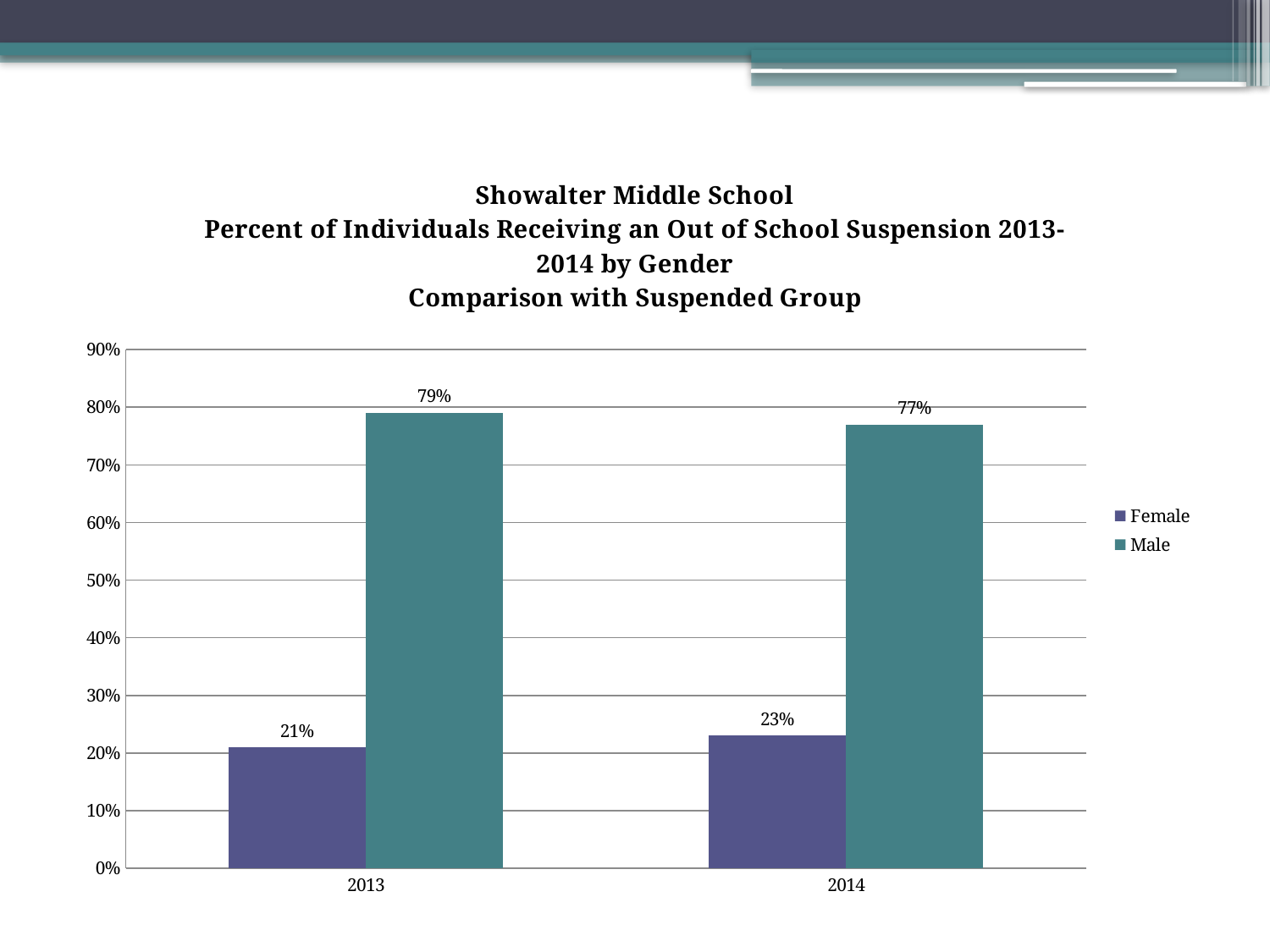
Does the Male value rise or fall from 2013 to 2014? Fall Which year has the lowest Female value? 2013 What is the Male value for 2013? 79% What is the difference between the Male and Female values in 2013? 58% Which is larger, the Female value for 2013 or the Female value for 2014? 2014 What is the Male value for 2014? 77% What kind of chart is shown on the slide? Bar chart How many years are shown on the x axis? 2 How many series does the legend list? 2 Which year has the highest Male value? 2013 What is the Female value for 2014? 23% What is the Female value for 2013? 21%